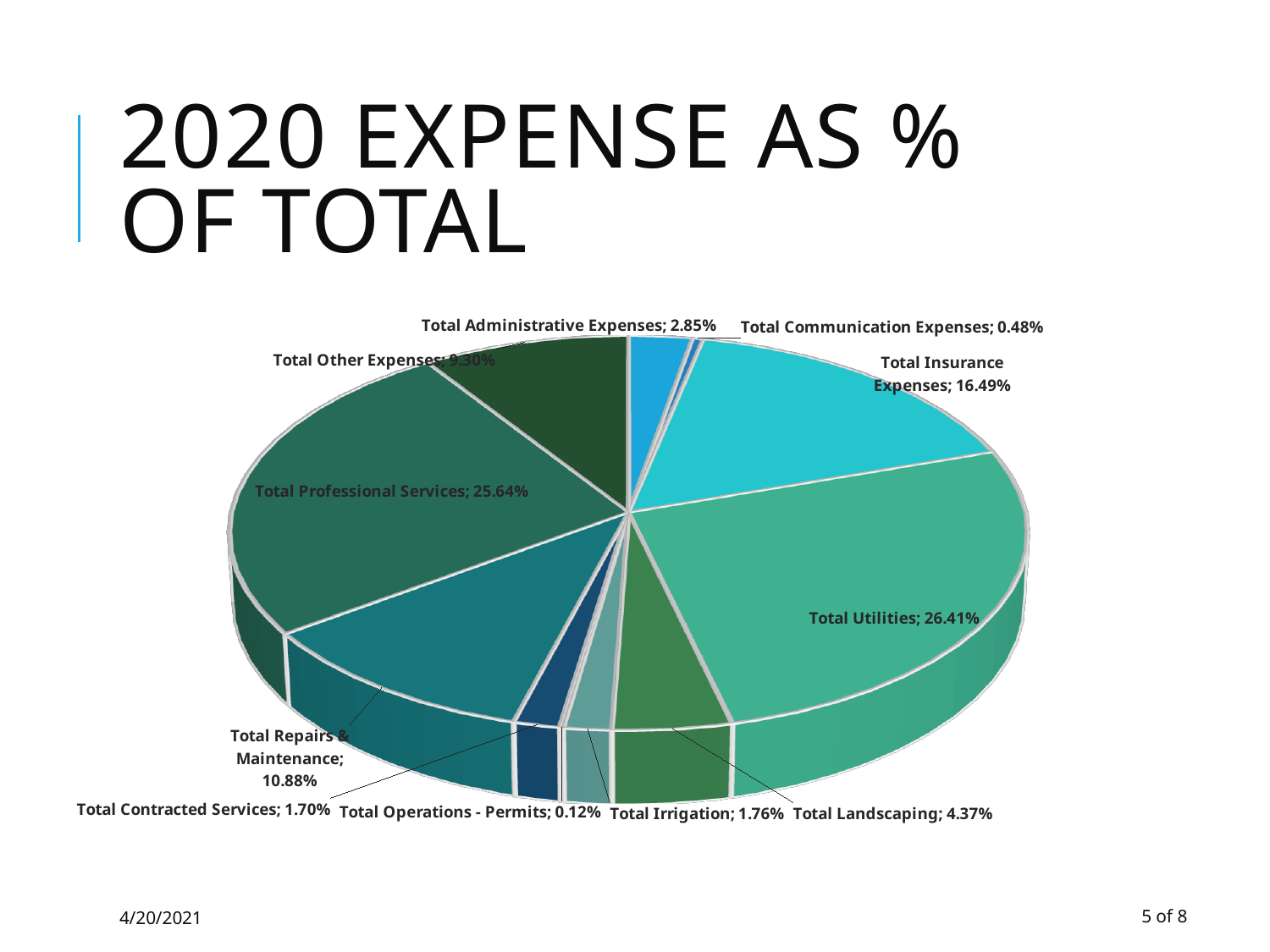
Which expense category has the smallest share of the pie? Total Operations - Permits How many expense categories are shown in the pie chart? 11 What percentage of total expense is Total Communication Expenses? 0.48% What kind of chart is shown on the slide? Pie chart What percentage of total expense is Total Contracted Services? 1.70% What is the difference in percentage points between Total Utilities and Total Professional Services? 0.77 percentage points Which is larger, Total Repairs & Maintenance or Total Landscaping? Total Repairs & Maintenance What percentage of total expense is Total Insurance Expenses? 16.49% What share of the pie does Total Landscaping represent? 4.37% What percentage of total expense is Total Utilities? 26.41% Which expense category has the largest share of the pie? Total Utilities What is the difference in percentage points between Total Insurance Expenses and Total Repairs & Maintenance? 5.61 percentage points